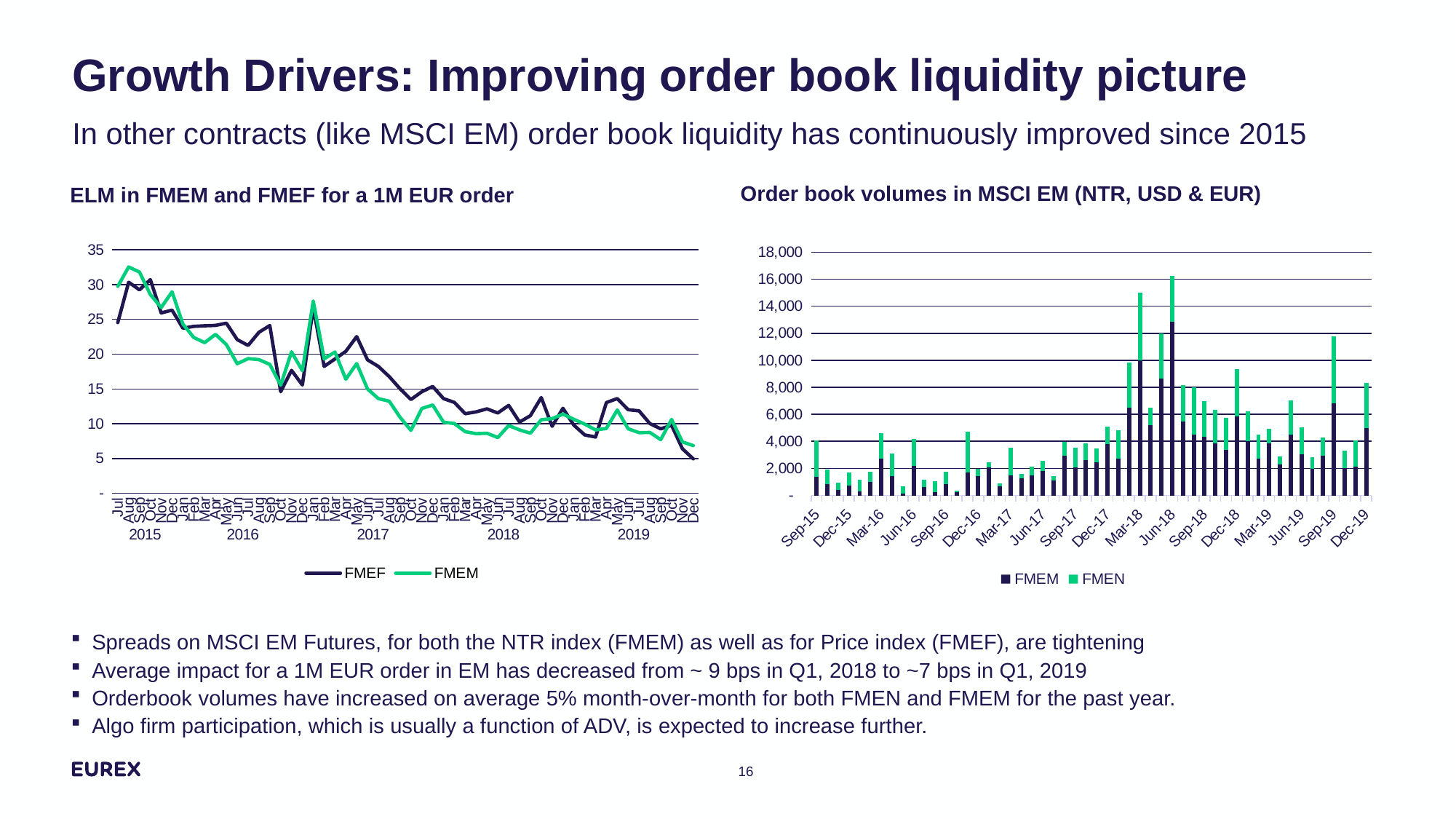
Which two series are listed in the legend of the right chart? FMEM and FMEN What kind of chart is the left chart titled 'ELM in FMEM and FMEF for a 1M EUR order'? line chart In the left chart, is the FMEM value in Aug 2015 greater or less than 30? greater In the right chart, do order book volumes generally rise or fall from Sep-15 to Dec-19? rise How many series does the legend of the left chart list? 2 In the left chart, do the ELM values generally rise or fall from 2015 to 2019? fall In the right chart, is the tallest stacked bar greater or less than 14,000? greater In the left chart, is the FMEM value at the end of 2019 (Dec) greater or less than 10? less What is the title of the right chart? Order book volumes in MSCI EM (NTR, USD & EUR) What kind of chart is the right chart titled 'Order book volumes in MSCI EM (NTR, USD & EUR)'? bar chart In the left chart, which series is higher in Aug 2015, FMEF or FMEM? FMEM